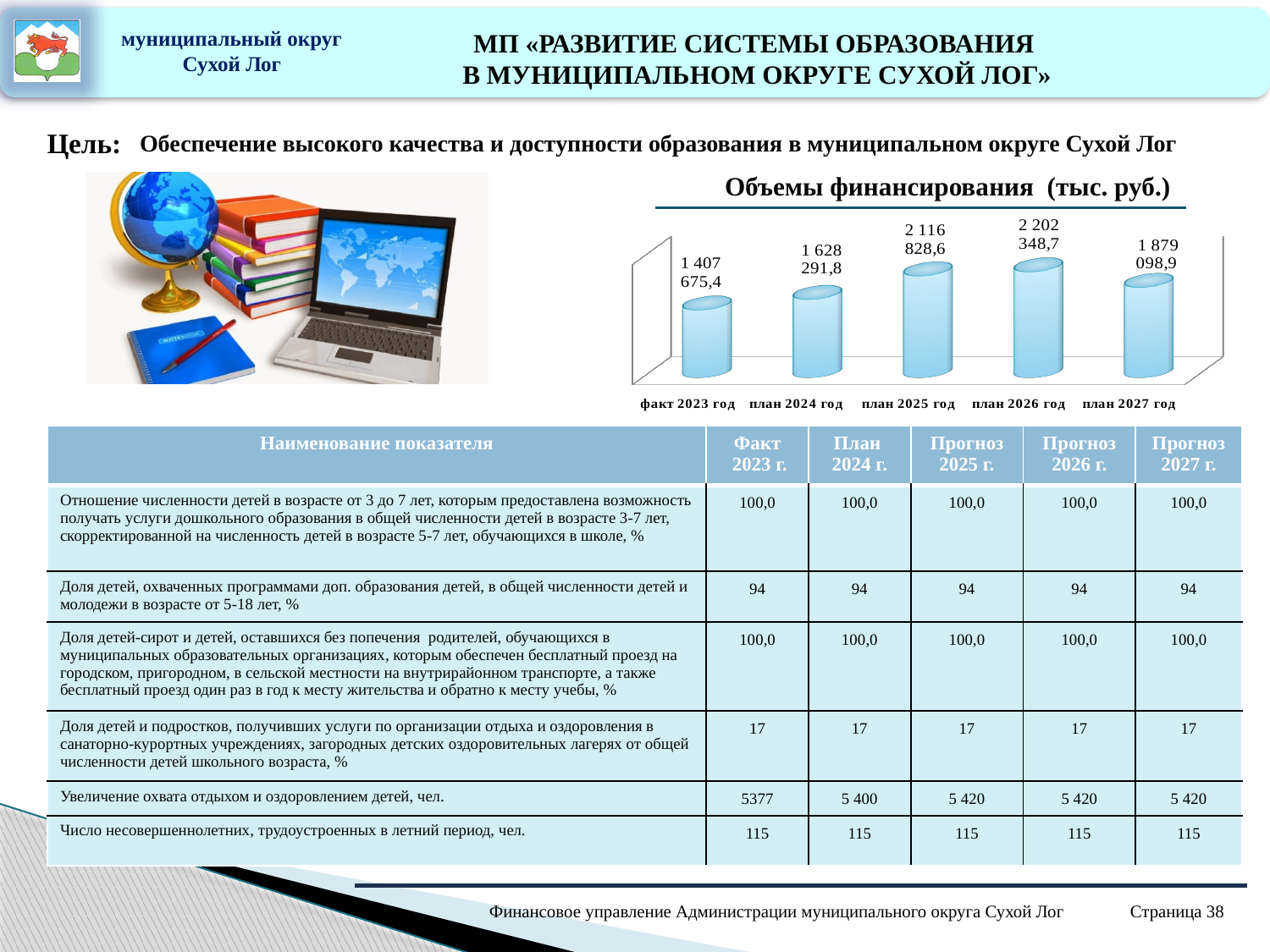
What unit is given in the title of the chart on the slide? тыс. руб. What is the value for факт 2023 год in the chart «Объемы финансирования (тыс. руб.)»? 1 407 675,4 In the chart «Объемы финансирования (тыс. руб.)», what is the difference between план 2026 год and план 2025 год? 85 520,1 How many categories are shown in the chart «Объемы финансирования (тыс. руб.)»? 5 What kind of chart is «Объемы финансирования (тыс. руб.)»? bar chart In the chart «Объемы финансирования (тыс. руб.)», which is larger: план 2025 год or план 2027 год? план 2025 год In the chart «Объемы финансирования (тыс. руб.)», do the values rise or fall from факт 2023 год to план 2026 год? rise Which category has the lowest value in the chart «Объемы финансирования (тыс. руб.)»? факт 2023 год Which category has the highest value in the chart «Объемы финансирования (тыс. руб.)»? план 2026 год In the chart «Объемы финансирования (тыс. руб.)», what is the difference between план 2024 год and факт 2023 год? 220 616,4 What is the value for план 2027 год in the chart «Объемы финансирования (тыс. руб.)»? 1 879 098,9 What is the value for план 2025 год in the chart «Объемы финансирования (тыс. руб.)»? 2 116 828,6